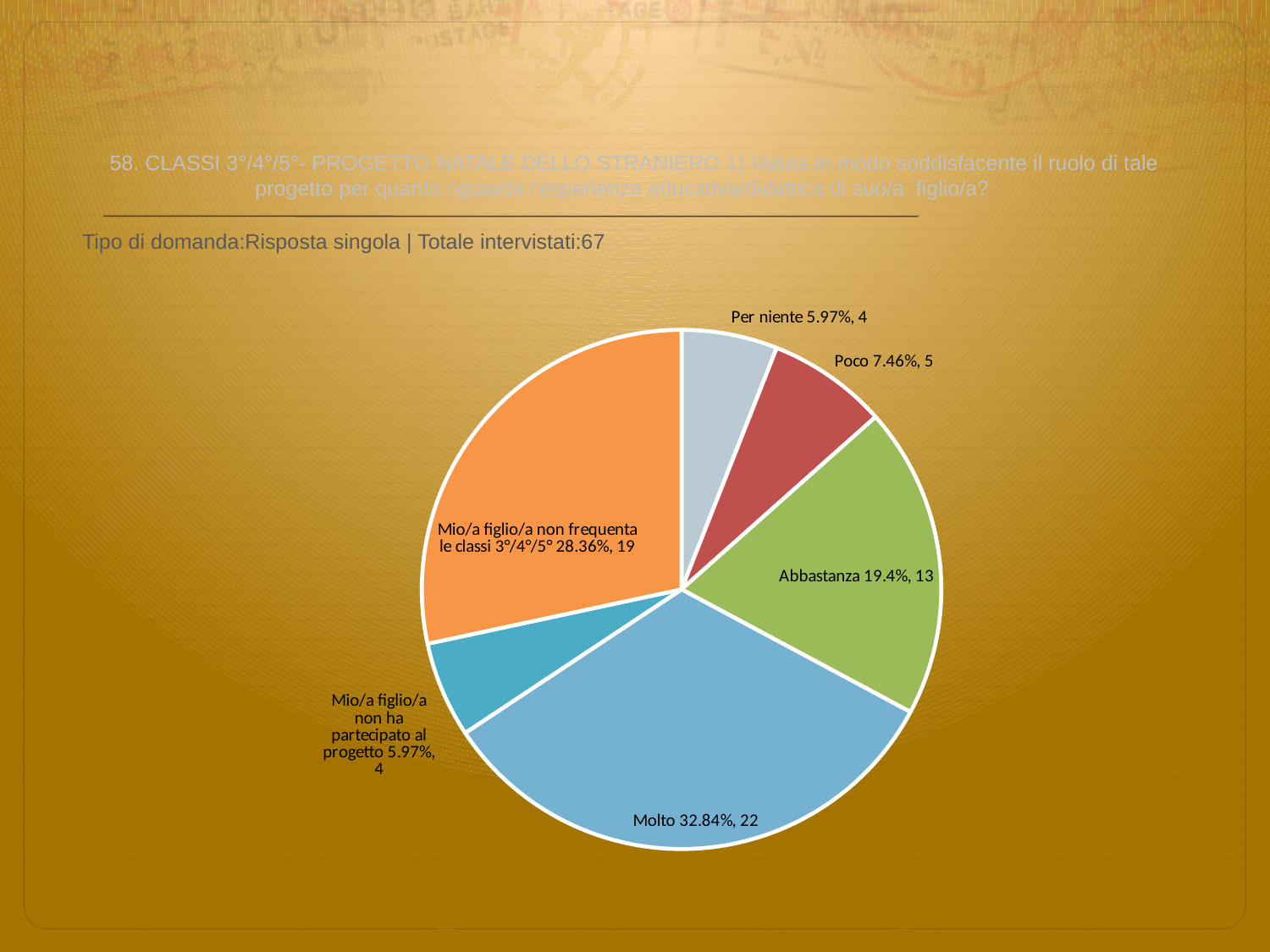
What kind of chart is shown on the slide? pie chart What is the count for "Molto" in the pie chart? 22 Which category has the largest slice in the pie chart? Molto What is the count for "Poco" in the pie chart? 5 What percentage share does "Per niente" have in the pie chart? 5.97% What is the total number of respondents (Totale intervistati) stated on the slide? 67 What is the difference in count between "Molto" and "Abbastanza" in the pie chart? 9 Which is larger in the pie chart, "Poco" or "Per niente"? Poco How many slices does the pie chart have? 6 What is the count for "Mio/a figlio/a non ha partecipato al progetto" in the pie chart? 4 What percentage share does "Mio/a figlio/a non frequenta le classi 3°/4°/5°" have in the pie chart? 28.36% What percentage share does "Abbastanza" have in the pie chart? 19.4%